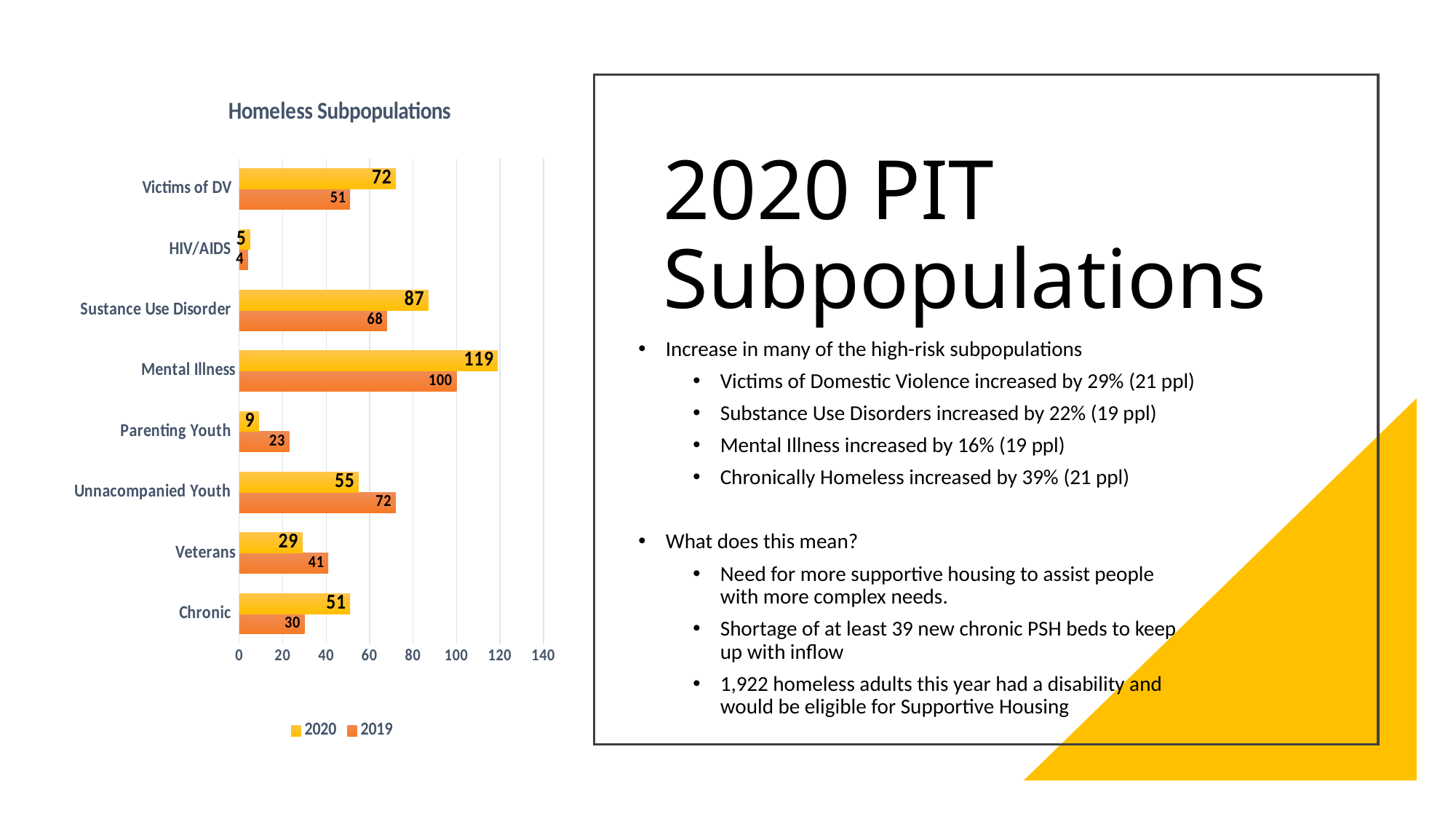
What is the 2019 value for Unnacompanied Youth? 72 Is the 2019 value for Sustance Use Disorder greater or less than 60? greater How many series does the legend list? 2 What kind of chart is shown? Bar chart What is the 2020 value for Mental Illness? 119 Which category has the highest 2020 value? Mental Illness What is the 2020 value for Parenting Youth? 9 Which is larger for Veterans, the 2020 value or the 2019 value? 2019 How many categories are shown on the chart? 8 Which category has the lowest 2019 value? HIV/AIDS What is the title of the chart? Homeless Subpopulations What is the difference between the 2020 and 2019 values for Victims of DV? 21